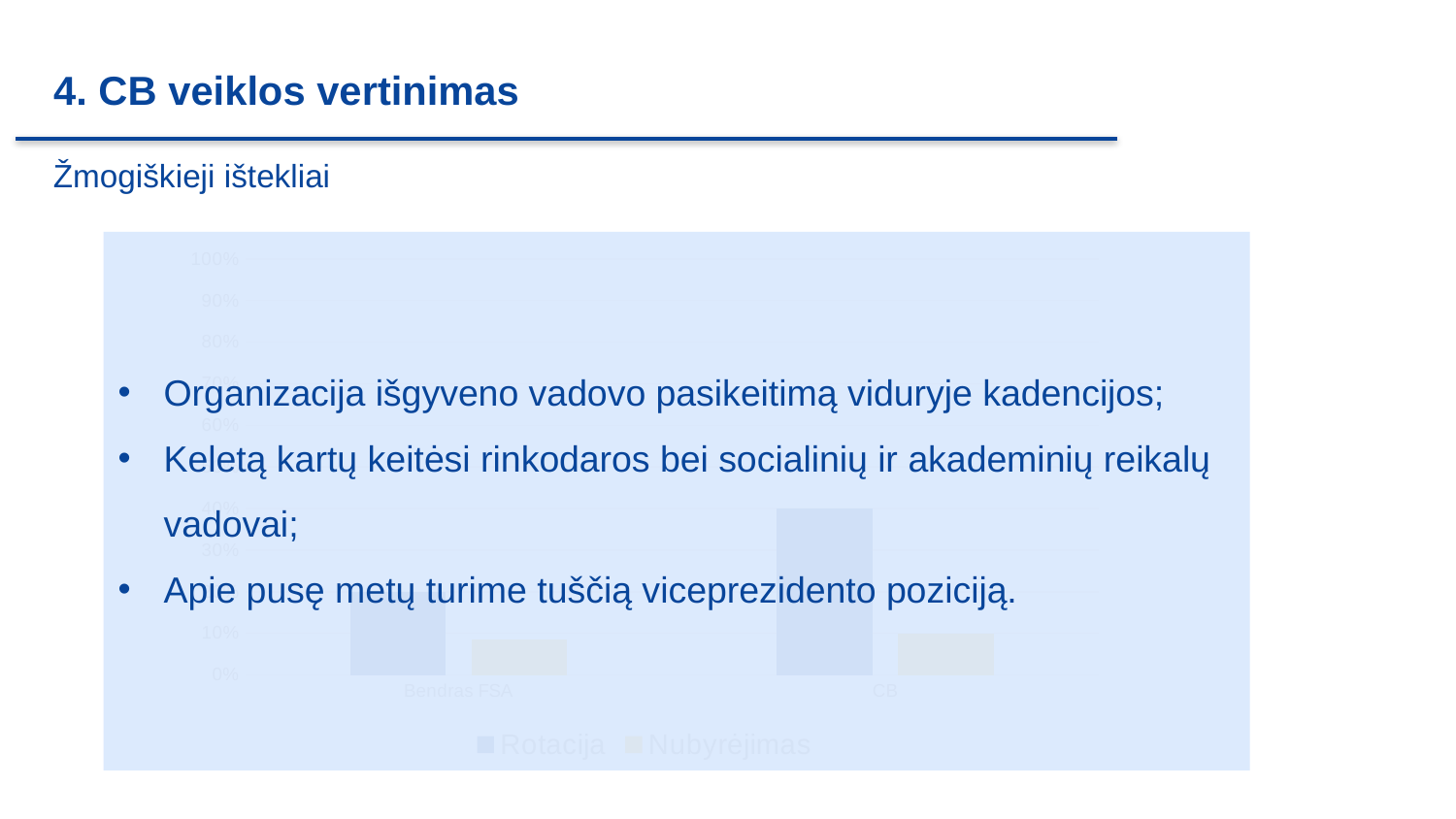
Which category has the higher Rotacija value, Bendras FSA or CB? CB Which bar in the chart is the tallest? Rotacija for CB How many categories are shown on the x axis of the chart? 2 For the CB category, which series has the larger value, Rotacija or Nubyrėjimas? Rotacija What are the two series named in the chart legend? Rotacija and Nubyrėjimas Is the Rotacija value for CB greater or less than 50%? less How many series does the chart legend list? 2 Is the Rotacija value for CB greater or less than 30%? greater What kind of chart is shown on the slide? bar chart For the Bendras FSA category, which series has the larger value, Rotacija or Nubyrėjimas? Rotacija What are the two categories on the x axis of the chart? Bendras FSA and CB